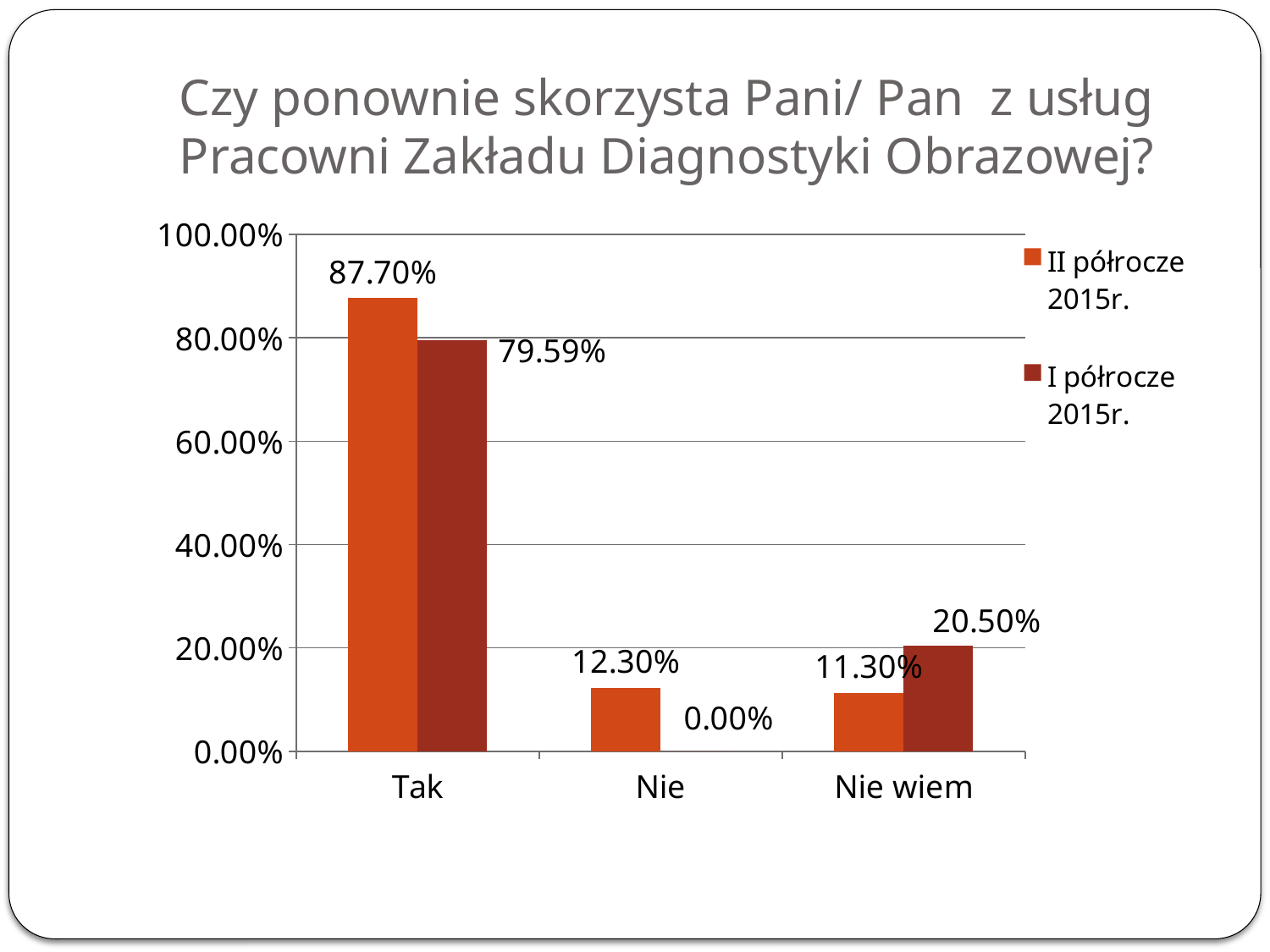
What is the value for "Nie" in the "II półrocze 2015r." series? 12.30% Which category has the lowest value in the "I półrocze 2015r." series? Nie How many categories are shown on the x axis? 3 What is the title of the chart? Czy ponownie skorzysta Pani/ Pan z usług Pracowni Zakładu Diagnostyki Obrazowej? What is the value for "Tak" in the "II półrocze 2015r." series? 87.70% For "Nie wiem", which series has the larger value: "II półrocze 2015r." or "I półrocze 2015r."? I półrocze 2015r. What is the value for "Nie wiem" in the "I półrocze 2015r." series? 20.50% What is the difference between the "II półrocze 2015r." and "I półrocze 2015r." values for "Tak"? 8.11% How many series does the legend list? 2 Which category has the highest value in the "II półrocze 2015r." series? Tak What kind of chart is shown on the slide? Bar chart What is the value for "Tak" in the "I półrocze 2015r." series? 79.59%